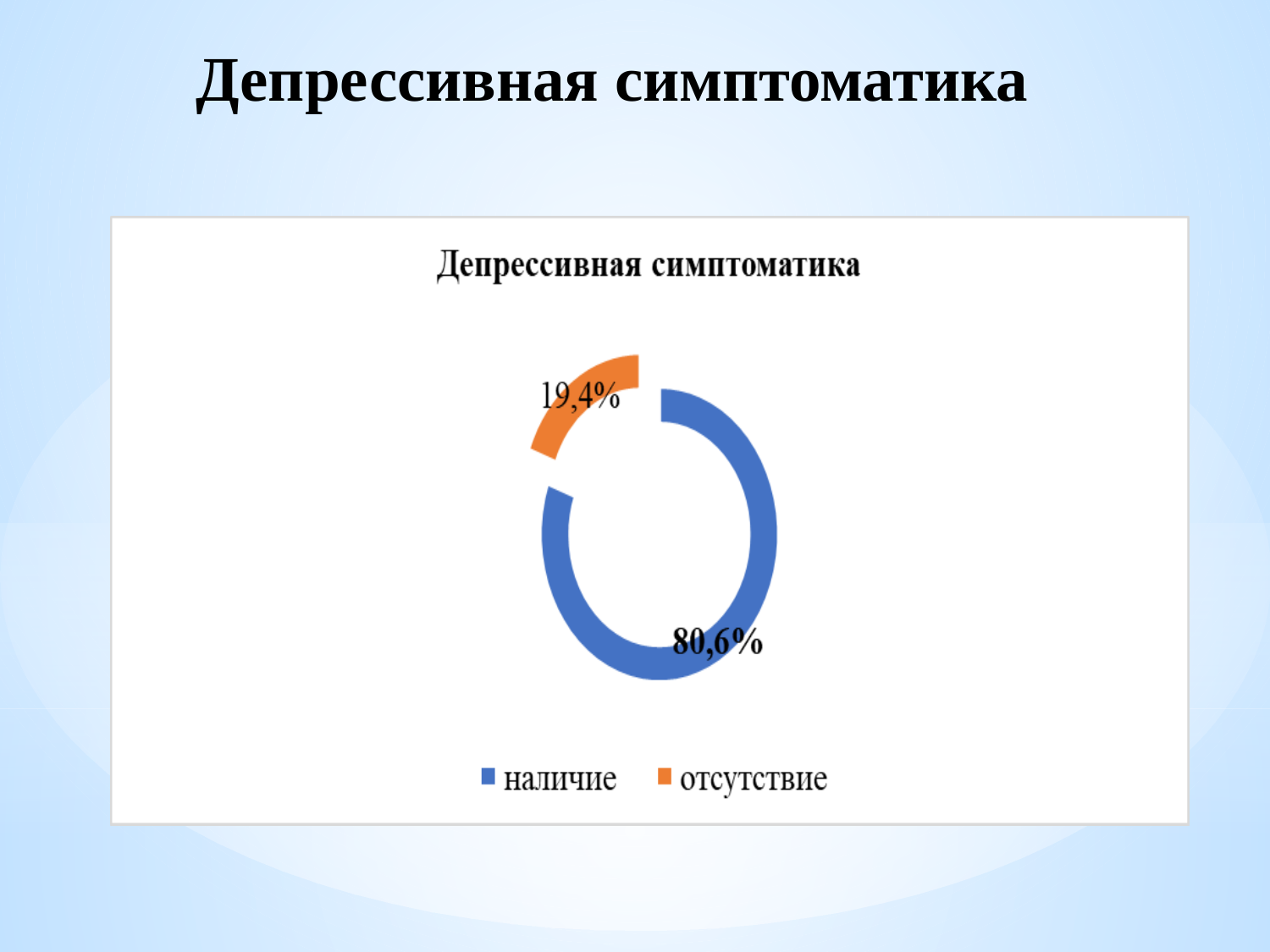
What is the title of the chart? Депрессивная симптоматика What is the difference between the values for наличие and отсутствие? 61,2% Which category has the smallest share? отсутствие What colour represents отсутствие in the chart? orange Which is larger, наличие or отсутствие? наличие What is the value for наличие? 80,6% Which category has the largest share? наличие What share of the chart does наличие represent? 80,6% What is the value for отсутствие? 19,4% How many categories does the chart show? 2 What kind of chart is shown? doughnut chart